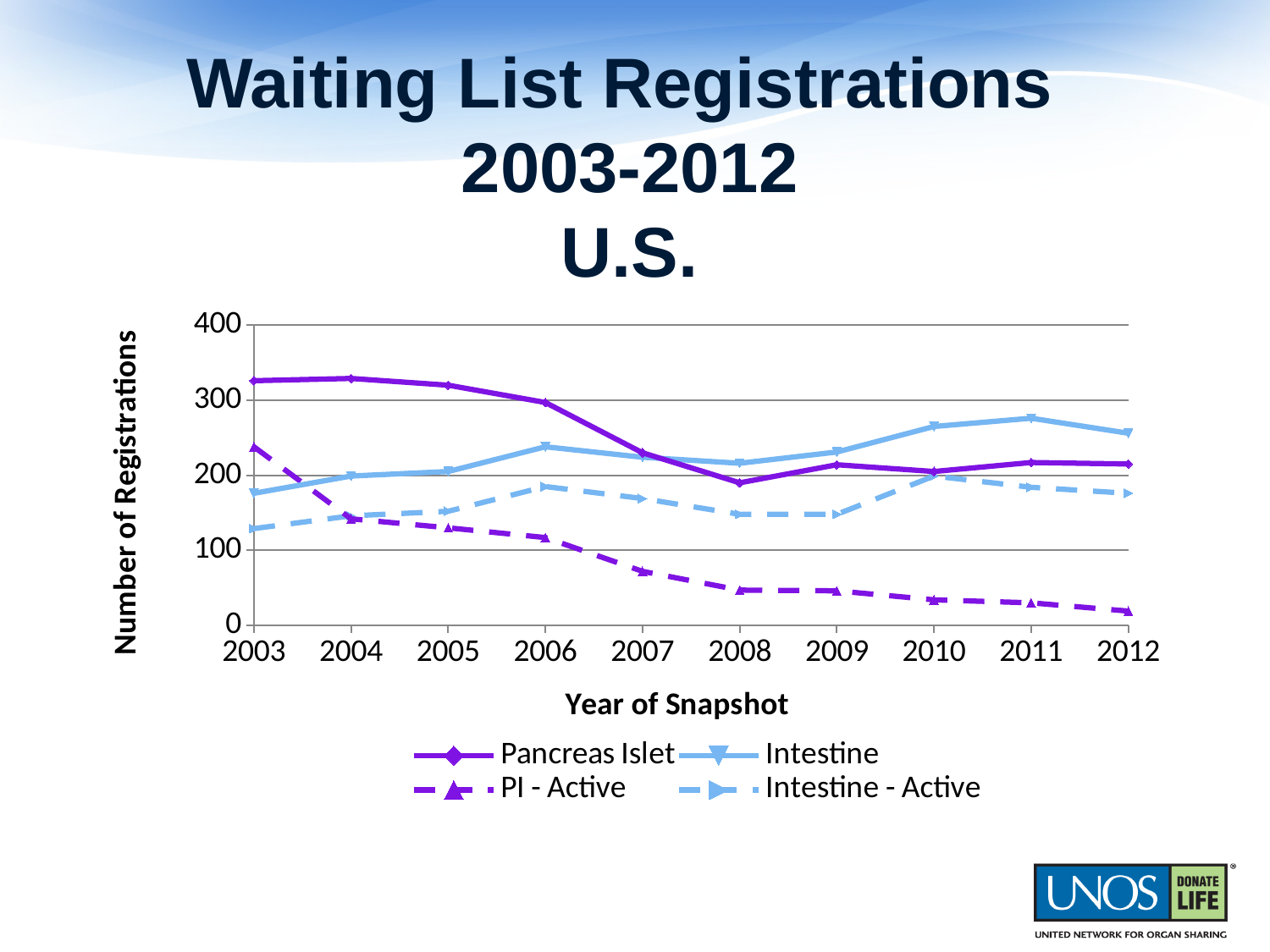
In which year is the Intestine - Active series highest? 2010 How many years are plotted along the x axis? 10 Does the PI - Active series rise or fall from 2003 to 2012? fall How many series does the legend list? 4 What kind of chart is shown on the slide? line chart What is the label of the y axis? Number of Registrations In which year is the PI - Active series lowest? 2012 In 2003, which is larger: Pancreas Islet or Intestine? Pancreas Islet Is the value for Intestine in 2011 greater or less than 200? greater In which year is the Intestine series highest? 2011 Is the value for Pancreas Islet in 2003 greater or less than 300? greater Is the value for PI - Active in 2012 greater or less than 100? less